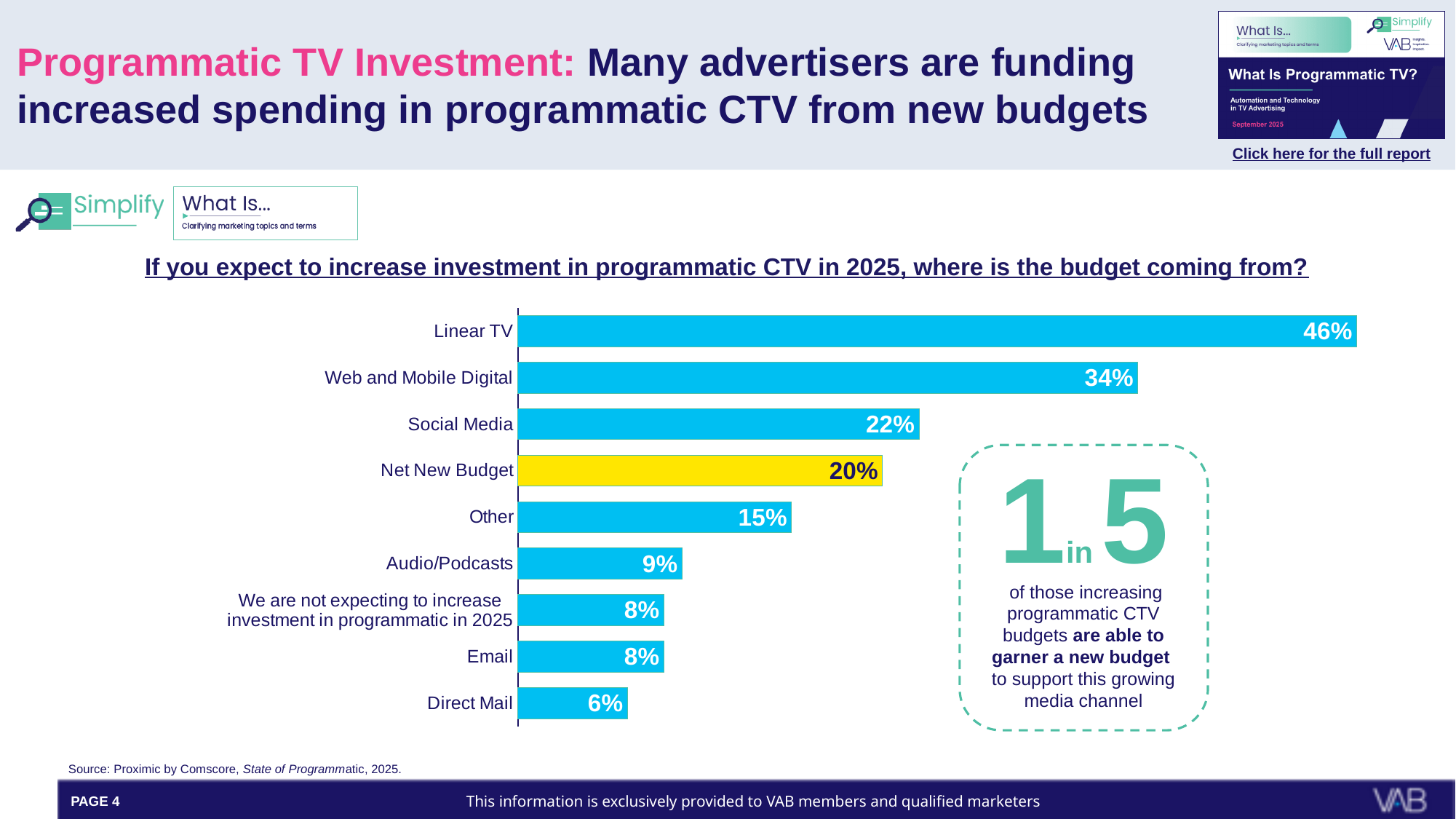
Which category has the lowest value in the chart? Direct Mail What percentage of respondents said their increased programmatic CTV budget is coming from Linear TV? 46% What type of chart is shown on the slide? Bar chart What value is shown for Email? 8% How many categories are shown in the bar chart? 9 What is the difference between the values for Net New Budget and Direct Mail? 14% What percentage is shown for Social Media? 22% Which is larger: the value for Other or the value for Audio/Podcasts? Other Which bar in the chart is highlighted in yellow rather than blue? Net New Budget What value is shown for Net New Budget? 20% What is the difference between the values for Linear TV and Web and Mobile Digital? 12% Which budget source has the highest value in the chart? Linear TV